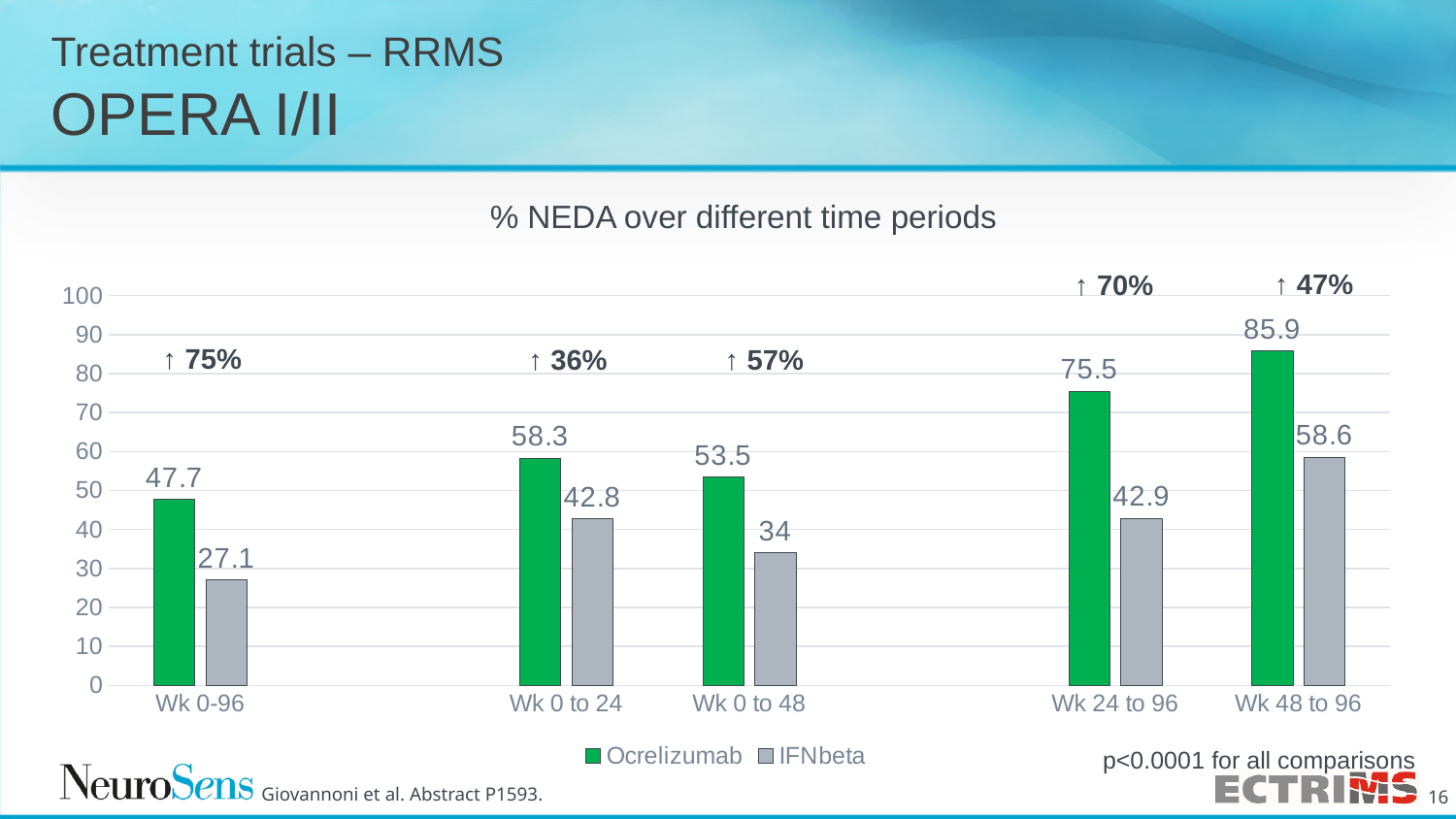
What percentage increase is annotated above the Wk 0-96 bars? ↑ 75% Which is larger, the Ocrelizumab value for Wk 0 to 24 or the Ocrelizumab value for Wk 0 to 48? Wk 0 to 24 Which time period has the lowest IFNbeta value? Wk 0-96 What is the difference between the Ocrelizumab and IFNbeta values for Wk 24 to 96? 32.6 How many series does the legend list? 2 What is the Ocrelizumab value for Wk 0-96? 47.7 What kind of chart is shown on the slide? Bar chart What is the IFNbeta value for Wk 48 to 96? 58.6 What is the IFNbeta value for Wk 0 to 48? 34 How many time periods are shown on the x axis? 5 What is the title of the chart? % NEDA over different time periods Which time period has the highest Ocrelizumab value? Wk 48 to 96